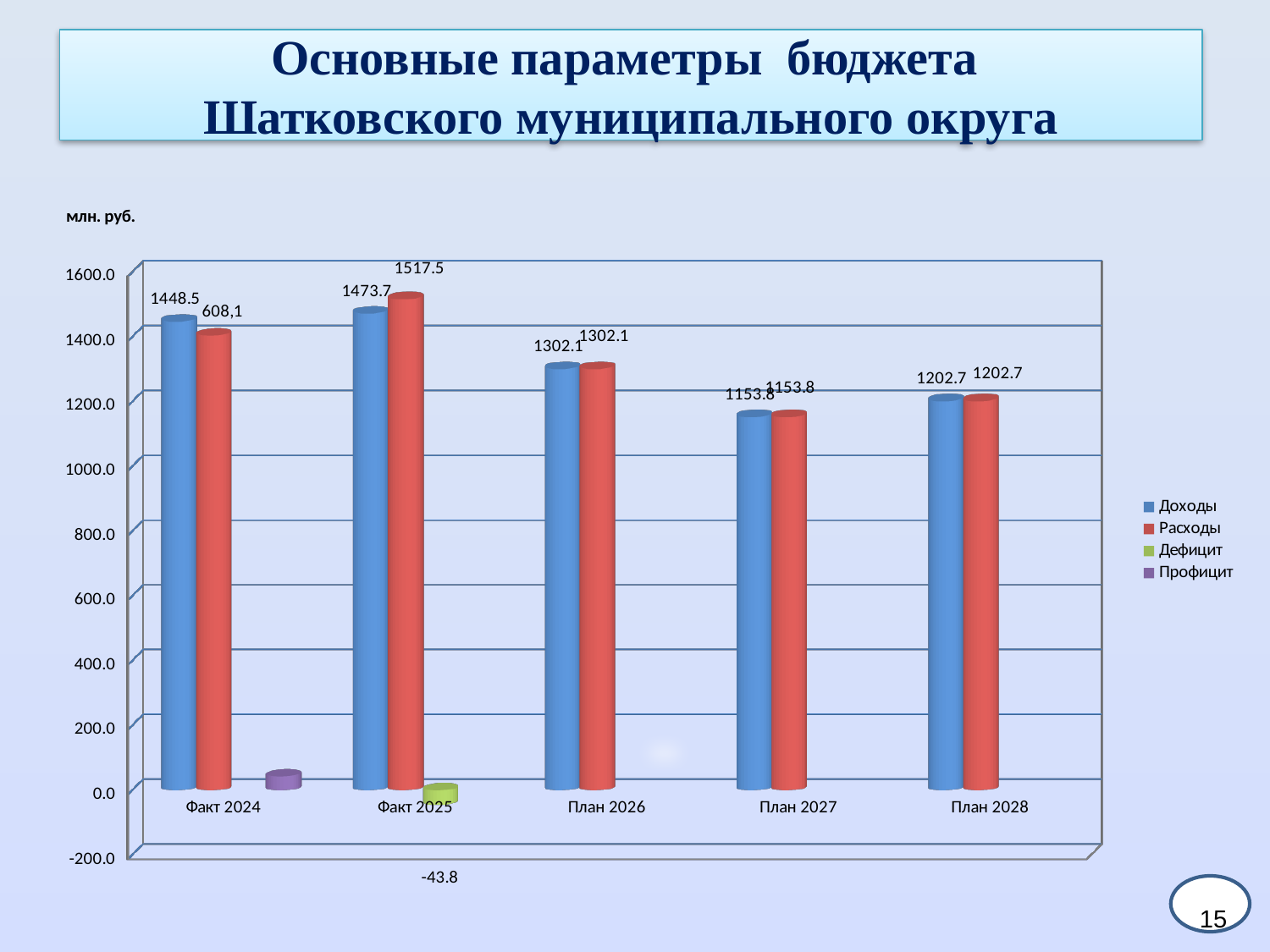
Is the value of Профицит for Факт 2024 greater or less than 200.0? less What is the difference between Расходы and Доходы for Факт 2025? 43.8 How many categories are shown on the x axis? 5 What type of chart is shown on the slide? bar chart What is the value of Дефицит for Факт 2025? -43.8 What is the value of Доходы for Факт 2024? 1448.5 What is the value of Доходы for План 2027? 1153.8 How many series does the legend list? 4 What is the value of Расходы for Факт 2025? 1517.5 Which is larger, Доходы for Факт 2024 or Доходы for Факт 2025? Факт 2025 In which category is Расходы the highest? Факт 2025 In which category is Доходы the lowest? План 2027